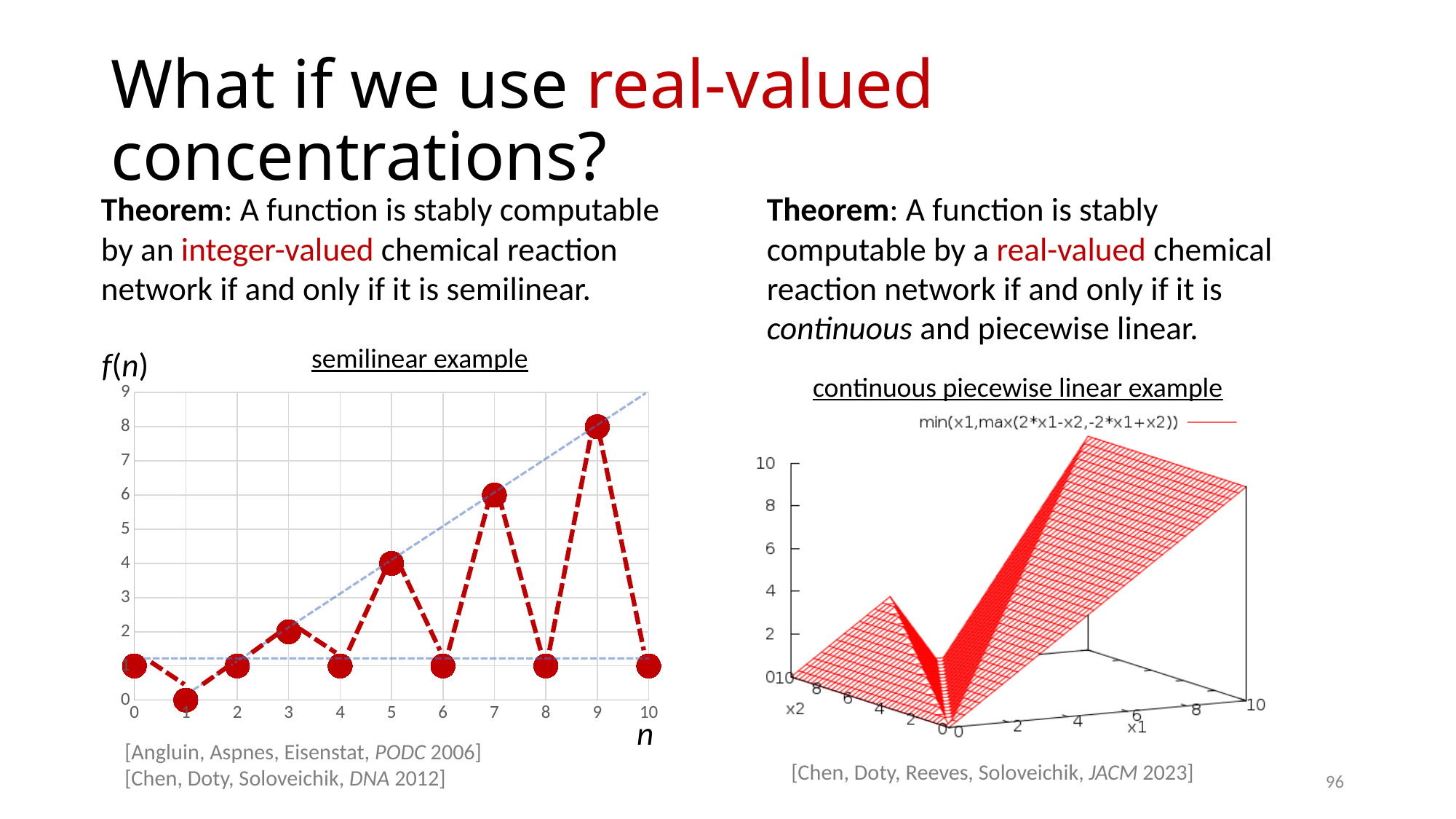
In the semilinear example chart, which is larger, f(5) or f(3)? f(5) In the semilinear example chart, how many data points are plotted? 11 In the semilinear example chart, what is the value of f(n) at n = 1? 0 In the semilinear example chart, at which value of n is f(n) lowest? 1 In the semilinear example chart, what is the value of f(n) at n = 3? 2 In the semilinear example chart, what is the value of f(n) at n = 9? 8 In the semilinear example chart, what is the difference between f(9) and f(7)? 2 What kind of chart is the continuous piecewise linear example? 3D surface plot In the semilinear example chart, what is the value of f(n) at n = 5? 4 In the continuous piecewise linear example chart, what function is named in the legend? min(x1,max(2*x1-x2,-2*x1+x2)) In the semilinear example chart, what is the label on the horizontal axis? n In the semilinear example chart, at which value of n is f(n) highest? 9